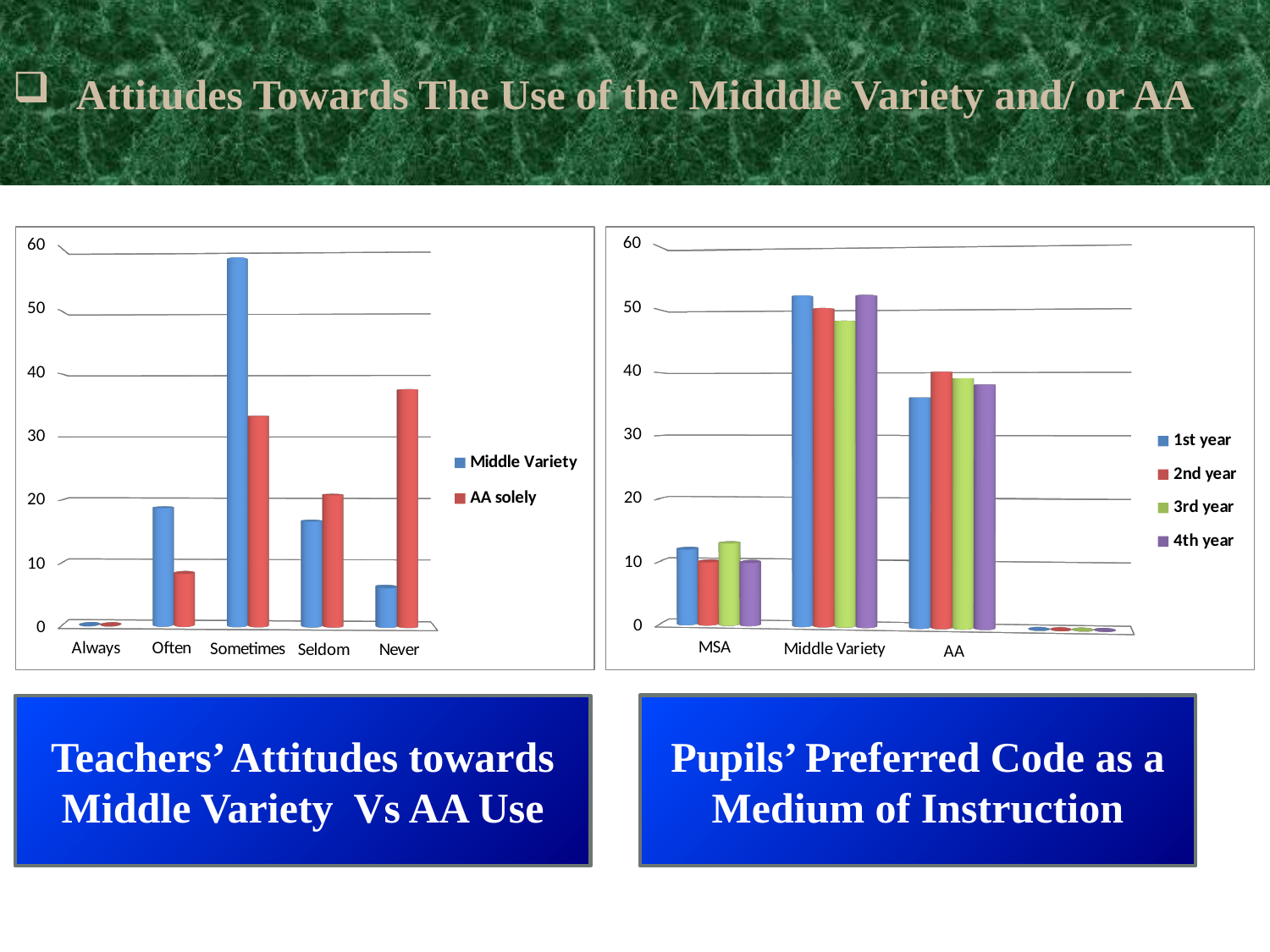
In the left chart (Teachers' Attitudes), which category has the highest value for Middle Variety? Sometimes How many categories are shown on the x axis of the right chart (Pupils' Preferred Code)? 3 In the left chart (Teachers' Attitudes), for the Often category, which series has the larger value, Middle Variety or AA solely? Middle Variety In the right chart (Pupils' Preferred Code), is the 1st year value for MSA greater or less than 20? less How many series does the legend of the right chart (Pupils' Preferred Code as a Medium of Instruction) list? 4 In the left chart (Teachers' Attitudes), is the AA solely value for Never greater or less than 30? greater In the left chart (Teachers' Attitudes), is the Middle Variety value for Sometimes greater or less than 50? greater What kind of chart is the left chart, Teachers' Attitudes towards Middle Variety Vs AA Use? bar chart How many series does the legend of the left chart (Teachers' Attitudes) list? 2 In the right chart (Pupils' Preferred Code), which category has the highest value for 1st year? Middle Variety In the left chart (Teachers' Attitudes), which category has the highest value for AA solely? Never How many categories are shown on the x axis of the left chart (Teachers' Attitudes)? 5